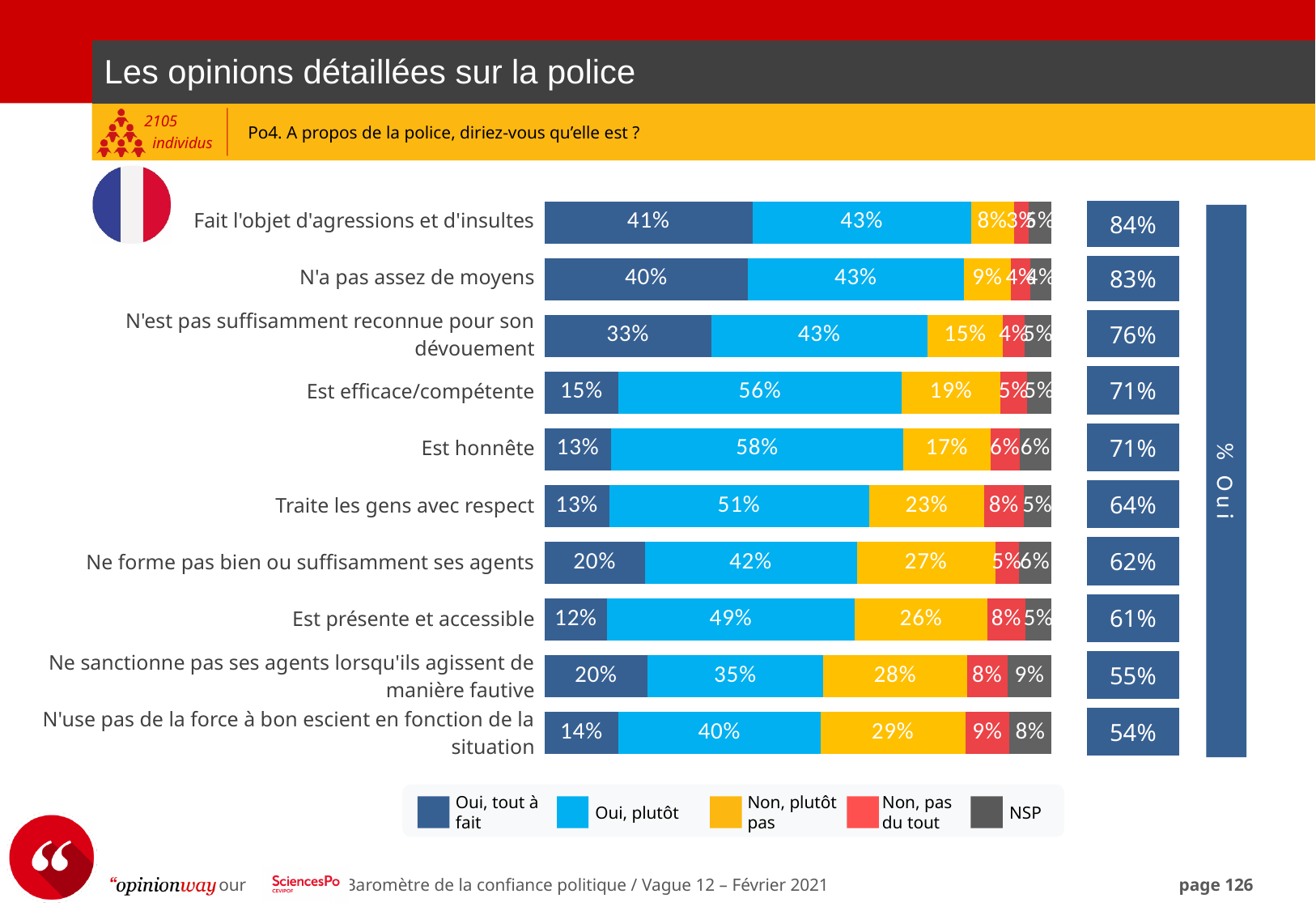
What percentage answered "Oui, plutôt" for "Est honnête"? 58% What is the combined share of "Oui, tout à fait" and "Oui, plutôt" for "Ne sanctionne pas ses agents lorsqu'ils agissent de manière fautive"? 55% Which statement has the highest "% Oui" value? Fait l'objet d'agressions et d'insultes What is the NSP value for "Ne sanctionne pas ses agents lorsqu'ils agissent de manière fautive"? 9% What is the "Oui, tout à fait" value for "Fait l'objet d'agressions et d'insultes"? 41% What is the difference in "% Oui" between "Est efficace/compétente" and "Est présente et accessible"? 10 percentage points Which statement has the lowest "% Oui" value? N'use pas de la force à bon escient en fonction de la situation How many statements (bars) are shown in the chart? 10 What is the "% Oui" value shown for "Traite les gens avec respect"? 64% How many response categories does the legend list? 5 What is the "Non, plutôt pas" value for "N'use pas de la force à bon escient en fonction de la situation"? 29% Which has a larger "Oui, plutôt" share: "Est efficace/compétente" or "Traite les gens avec respect"? Est efficace/compétente